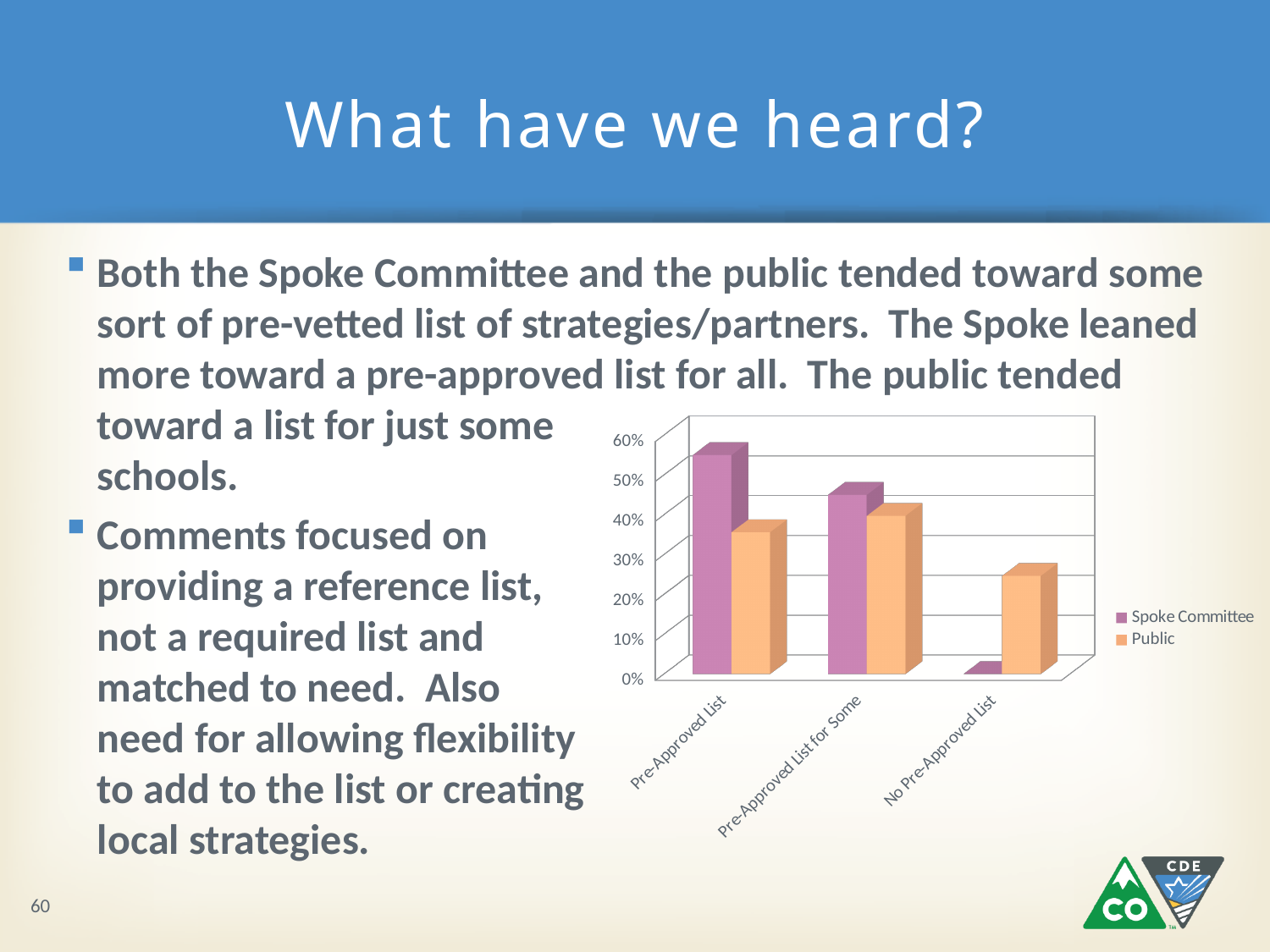
For Pre-Approved List, which series has the larger value, Spoke Committee or Public? Spoke Committee How many series does the chart legend list? 2 For No Pre-Approved List, which series has the larger value, Spoke Committee or Public? Public How many categories are shown on the chart's x axis? 3 What kind of chart is shown on the slide? bar chart Is the Spoke Committee value for Pre-Approved List greater or less than 50%? greater Is the Public value for No Pre-Approved List greater or less than 30%? less Which series are listed in the chart legend? Spoke Committee and Public For which category is the Public value lowest? No Pre-Approved List Is the Spoke Committee value for No Pre-Approved List greater or less than 10%? less For which category is the Spoke Committee value highest? Pre-Approved List For which category is the Spoke Committee value lowest? No Pre-Approved List